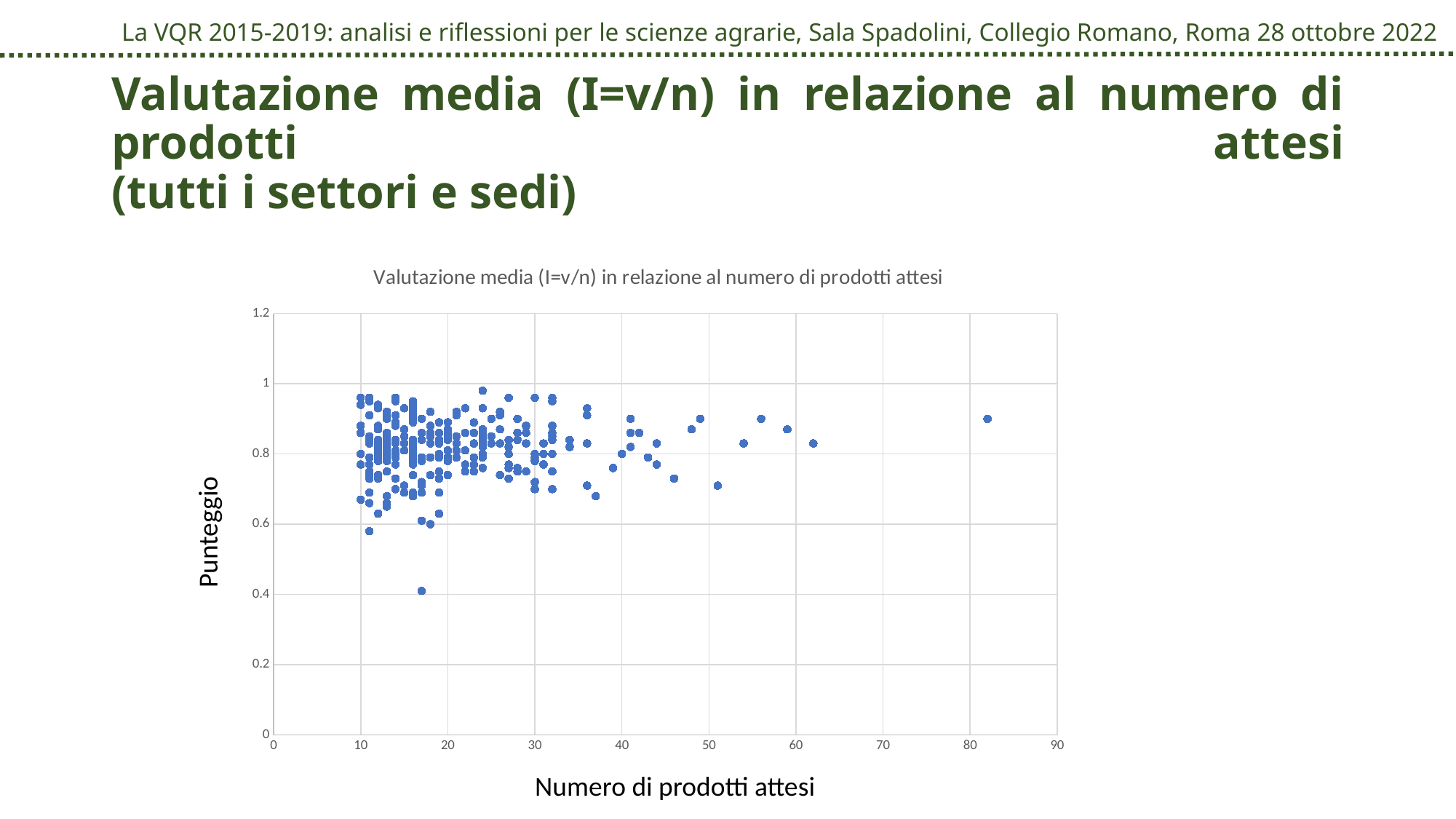
What kind of chart is shown on the slide? Scatter plot Is the Numero di prodotti attesi of the rightmost point greater or less than 80? greater Is the highest Punteggio on the chart greater or less than 1.2? less What is the title of the chart? Valutazione media (I=v/n) in relazione al numero di prodotti attesi Is the Punteggio of the lowest point on the chart greater or less than 0.6? less What is the label of the vertical axis of the chart? Punteggio